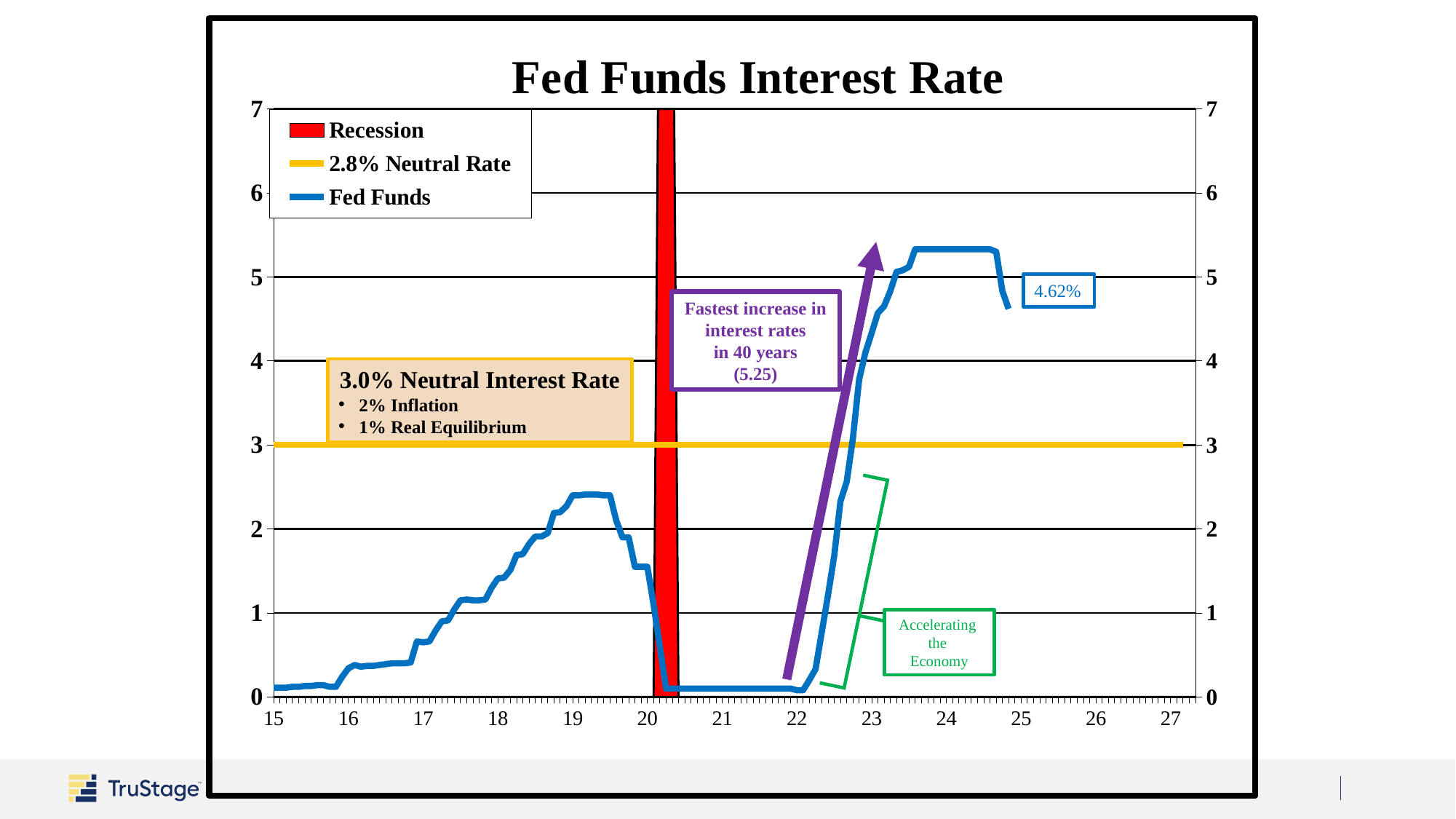
What neutral rate value is given in the legend entry for the yellow line? 2.8% Neutral Rate Does the Fed Funds line rise or fall between 19.5 and 20.5 on the x axis? fall Does the Fed Funds line rise or fall between 22 and 23 on the x axis? rise Which is larger, the Fed Funds value at 24 or at 19? 24 Is the Fed Funds value at 19 greater or less than 2? greater Is the Fed Funds value at 21 greater or less than 1? less What is the title of the chart? Fed Funds Interest Rate Is the Fed Funds value at 24 greater or less than 5? greater What colour is the Fed Funds line in the legend? blue What kind of chart is shown on the slide? line chart What value is printed in the data label at the end of the Fed Funds line? 4.62% How many entries does the chart's legend list? 3